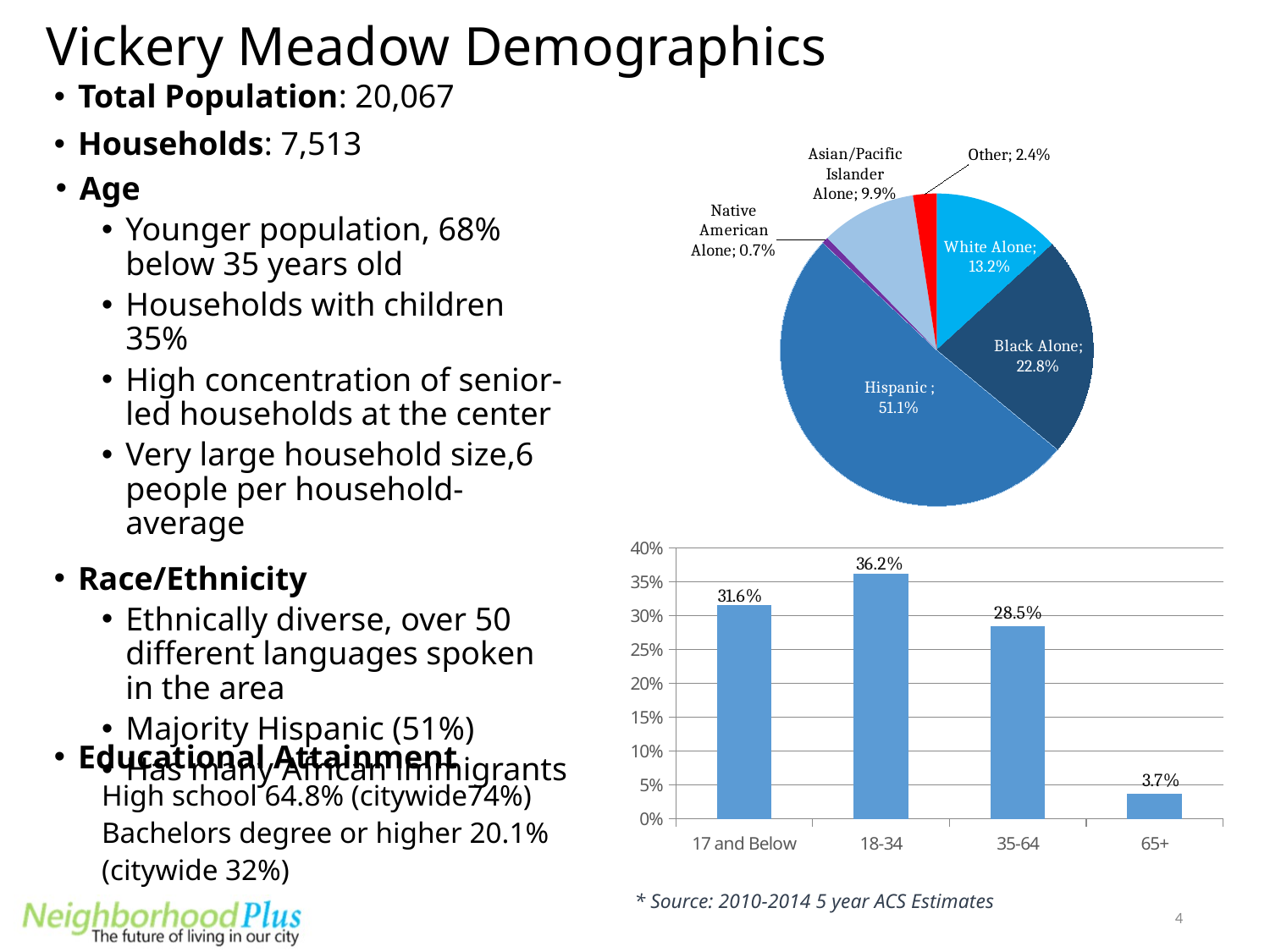
In the pie chart, what is the difference between the White Alone share and the Asian/Pacific Islander Alone share? 3.3% In the pie chart, what share is labelled for Hispanic? 51.1% What kind of chart is the lower chart on the slide? Bar chart In the bar chart, what is the value for the 18-34 age group? 36.2% In the pie chart, which slice is the smallest? Native American Alone In the pie chart, how many slices are there? 6 In the bar chart, which age group has the highest value? 18-34 In the pie chart, what share is labelled for Black Alone? 22.8% In the bar chart, what is the value for the 65+ age group? 3.7% In the bar chart, what is the difference between the 17 and Below value and the 35-64 value? 3.1% In the bar chart, how many age groups are shown? 4 In the pie chart, which slice is the largest? Hispanic